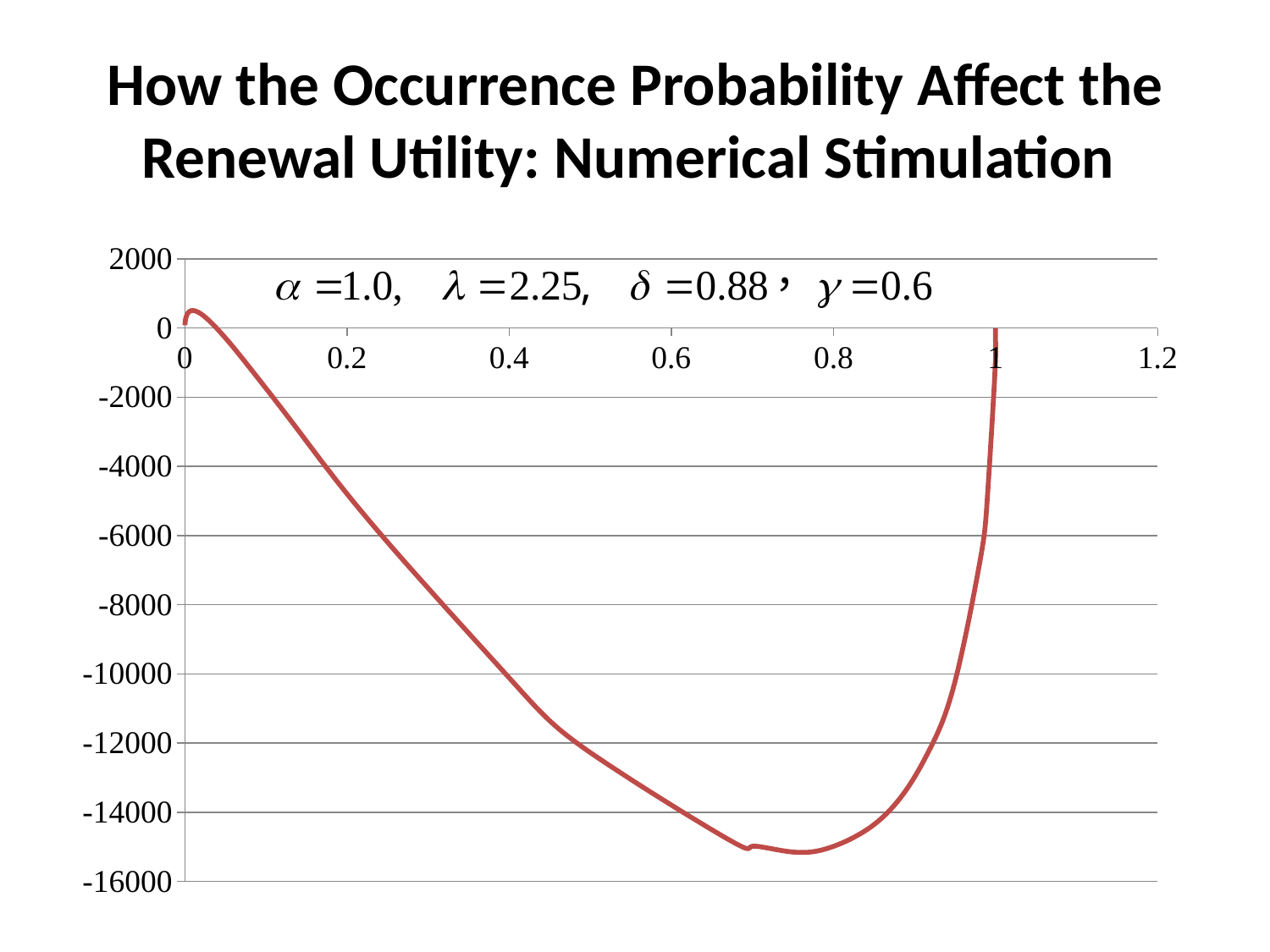
Is the value of the curve at x = 0.9 greater or less than -14000? greater Does the curve rise or fall as x increases from 0.1 to 0.6? fall Is the value of the curve at x = 0.2 greater or less than -6000? greater Which has the higher value on the curve, x = 0.2 or x = 0.8? x = 0.2 Does the curve rise or fall as x increases from 0.8 to 1.0? rise Is the value of the curve at x = 0.4 greater or less than -8000? less What value of λ is stated on the chart? 2.25 What value of δ is stated on the chart? 0.88 What kind of chart is shown on the slide? line chart